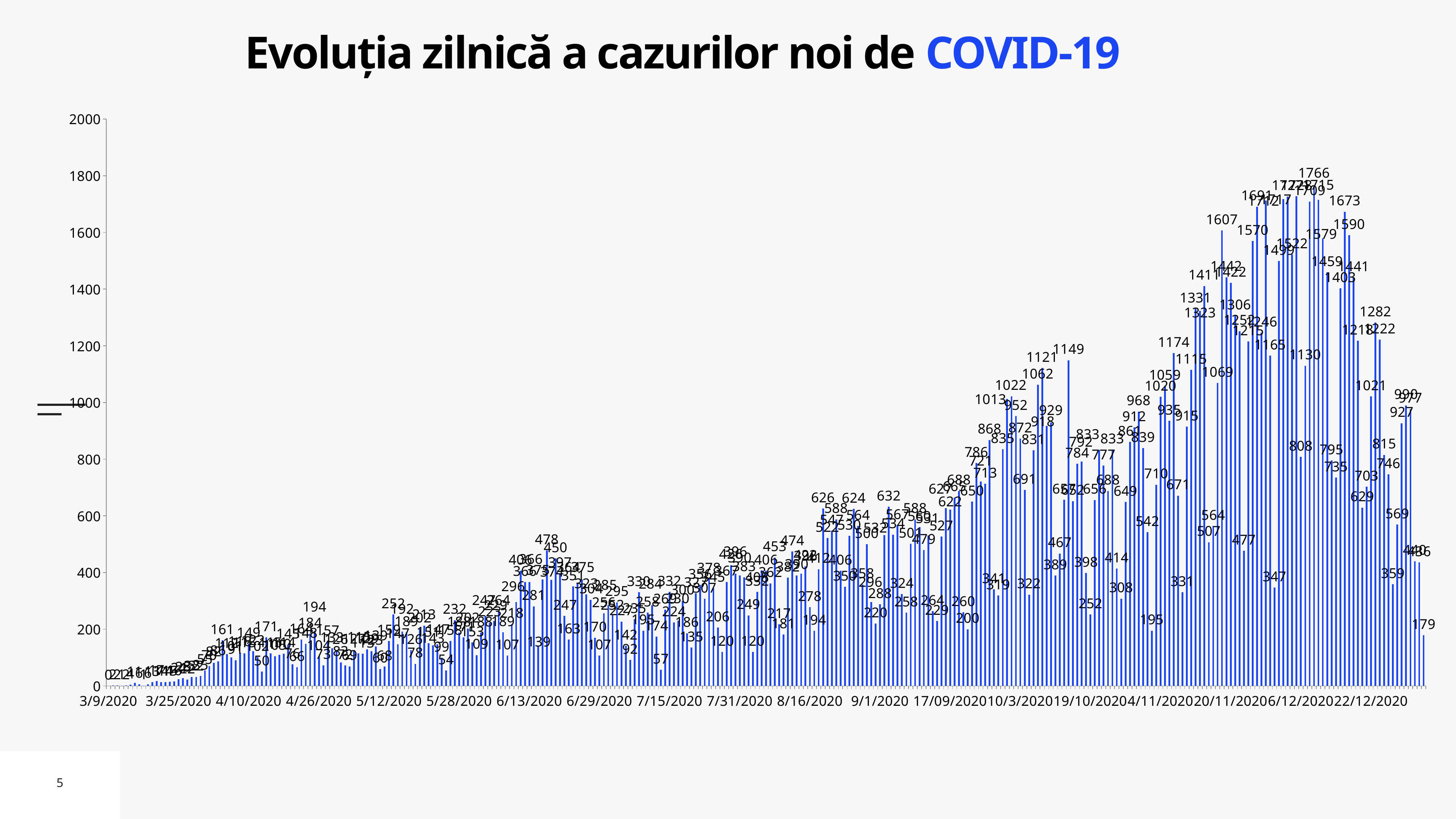
Is the tallest bar on the chart greater or less than 1600? greater What is the difference between the bars labeled 1766 and 1607? 159 What is the first date label on the horizontal axis? 3/9/2020 What is the highest daily value labeled on the chart? 1766 What is the highest value shown on the vertical axis? 2000 What is the value labeled on the last bar at the right end of the chart? 179 Overall, do the daily values rise or fall from March 2020 to December 2020? rise What kind of chart is shown on the slide? bar chart What is the title of the chart? Evoluția zilnică a cazurilor noi de COVID-19 What is the value of the first bar, for 3/9/2020? 0 Which is larger, the bar labeled 1766 or the bar labeled 1607? 1766 Is the tallest bar on the chart greater or less than 1800? less